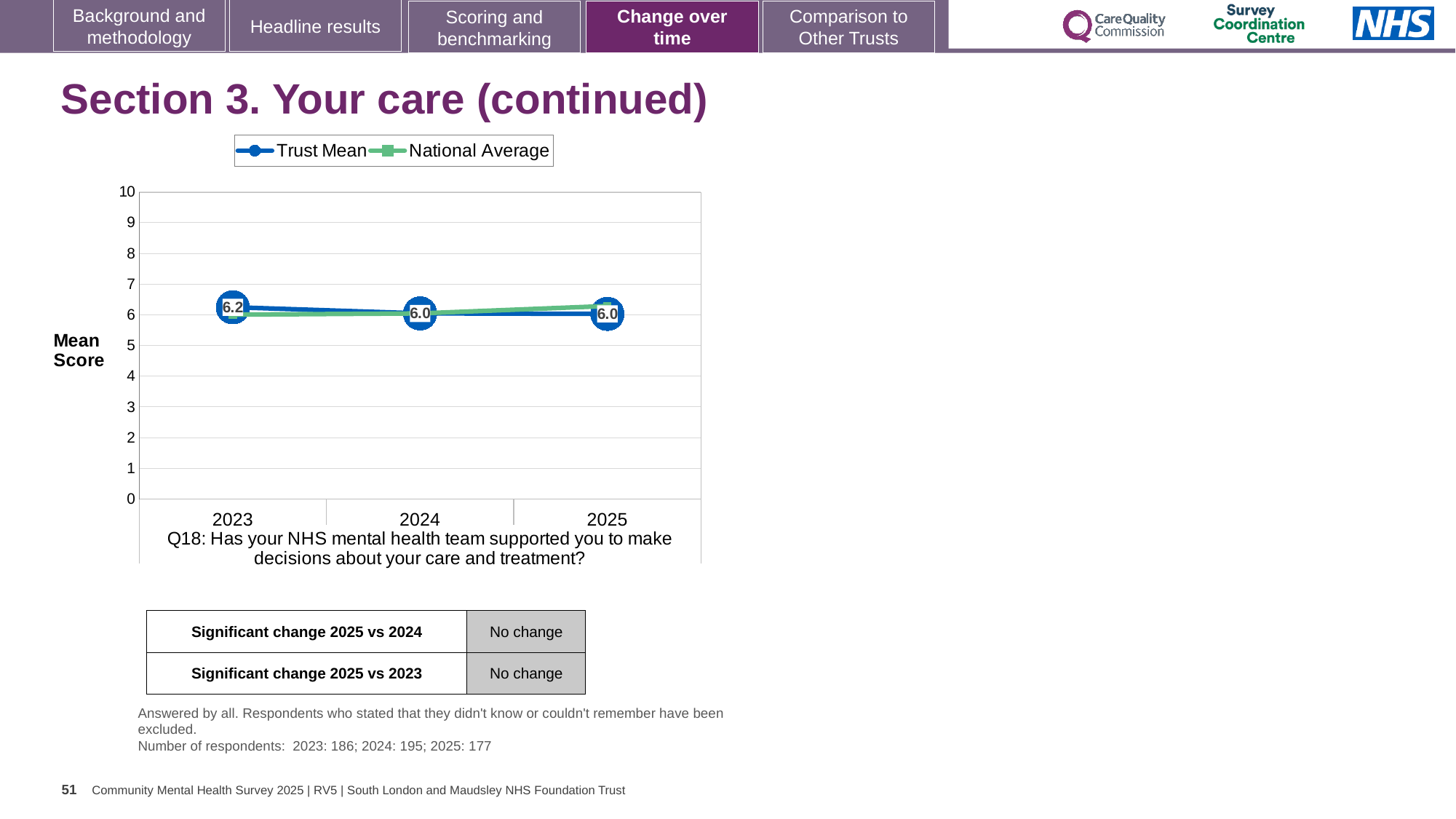
How many series does the chart legend list? 2 Is the Trust Mean for 2023 larger than the Trust Mean for 2024? Yes What is the difference between the Trust Mean in 2023 and in 2025? 0.2 What is the Trust Mean value for 2024? 6.0 Does the Trust Mean rise or fall from 2023 to 2025? Fall How many years are shown on the x axis of the chart? 3 What is the Trust Mean value for 2023? 6.2 What kind of chart is shown on the slide? Line chart What is the Trust Mean value for 2025? 6.0 Is the National Average value for 2025 greater or less than 5? greater In which year is the Trust Mean highest? 2023 What are the two series named in the chart legend? Trust Mean and National Average